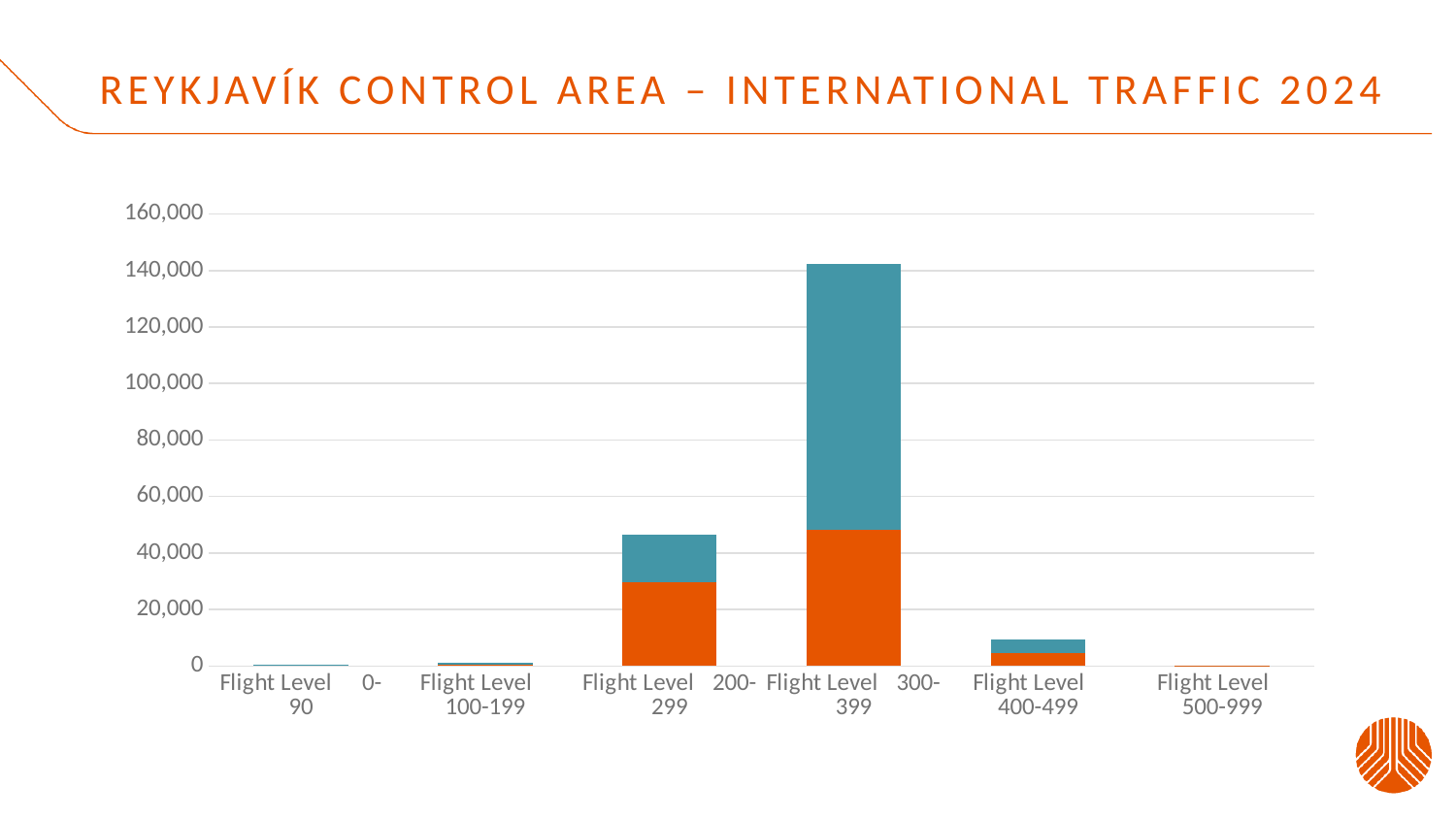
Which flight level category has the highest total bar? Flight Level 300-399 Is the total value for Flight Level 100-199 greater or less than 20,000? less What is the title of the chart slide? Reykjavík Control Area – International Traffic 2024 Is the total value for Flight Level 200-299 greater or less than 40,000? greater Is the total value for Flight Level 200-299 greater or less than 60,000? less Which has a larger total bar, Flight Level 200-299 or Flight Level 400-499? Flight Level 200-299 How many flight level categories are shown on the x axis? 6 How many coloured segments are stacked in each bar? 2 Which has a larger total bar, Flight Level 300-399 or Flight Level 200-299? Flight Level 300-399 What kind of chart is shown on the slide? bar chart